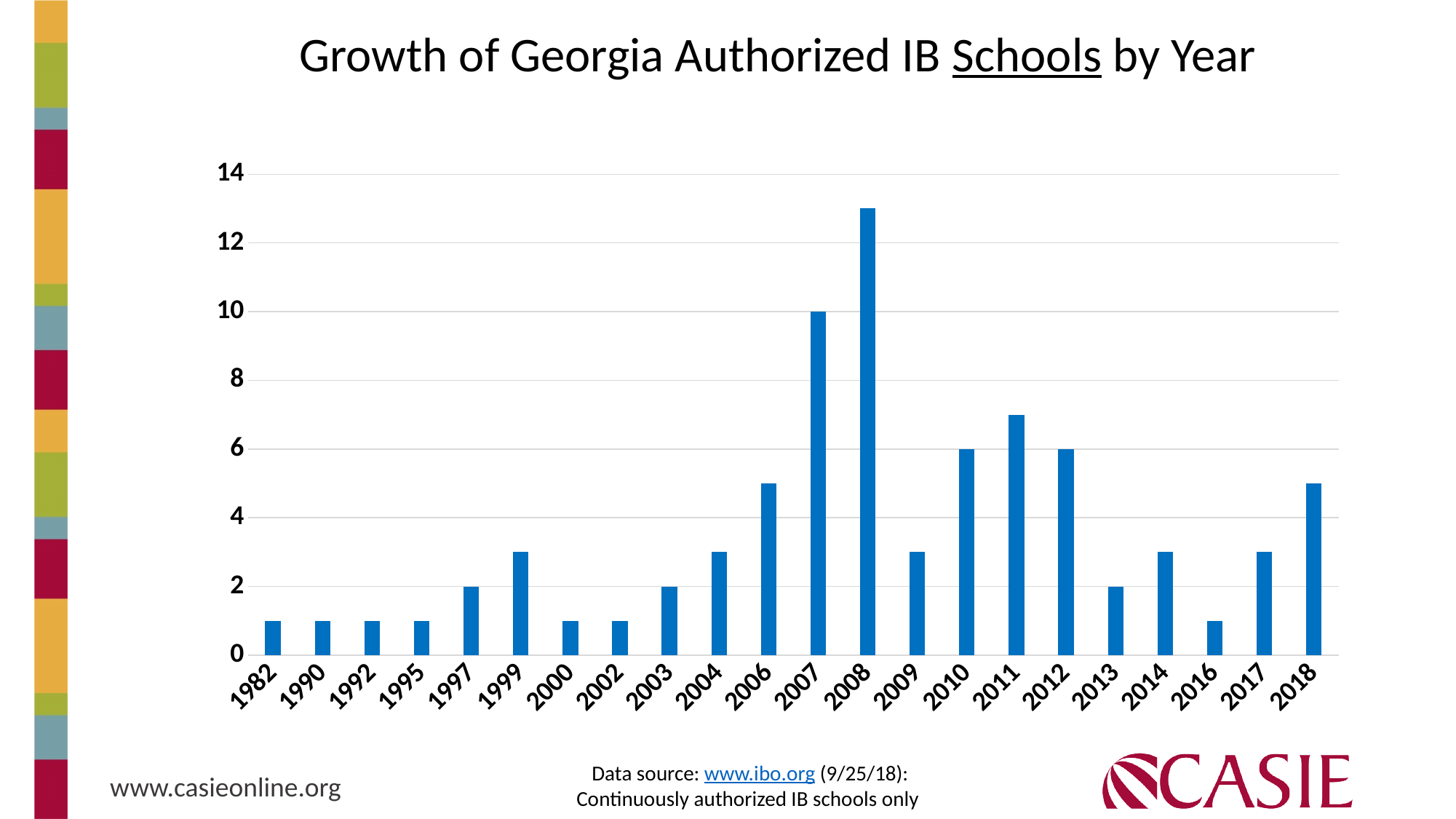
What kind of chart is shown on the slide? bar chart What is the value for 2007? 10 What is the value for 1997? 2 What is the title of the chart? Growth of Georgia Authorized IB Schools by Year Do the values rise or fall from 2006 to 2008? rise Which is larger, the value for 2007 or the value for 2011? 2007 Is the value for 2008 greater or less than 12? greater How many years are shown on the x axis of the chart? 22 What is the difference between the values for 2007 and 2010? 4 What is the value for 2010? 6 Which year has the highest number of authorized IB schools? 2008 Is the value for 1982 greater or less than 2? less